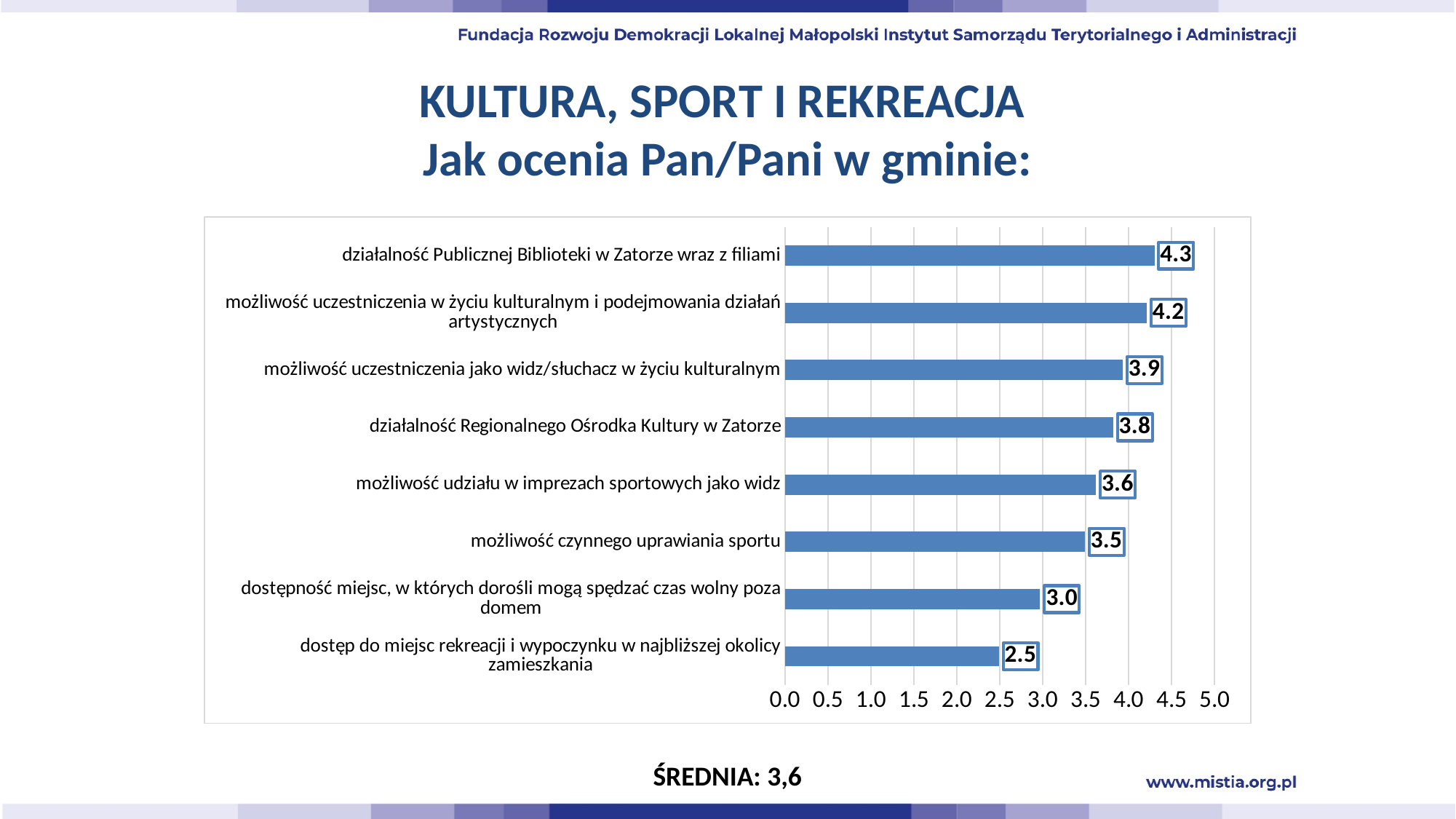
What is the value for "działalność Publicznej Biblioteki w Zatorze wraz z filiami"? 4.3 What is the value for "możliwość czynnego uprawiania sportu"? 3.5 What is the difference between the values for "działalność Publicznej Biblioteki w Zatorze wraz z filiami" and "dostęp do miejsc rekreacji i wypoczynku w najbliższej okolicy zamieszkania"? 1.8 What is the value for "działalność Regionalnego Ośrodka Kultury w Zatorze"? 3.8 What is the difference between the values for "możliwość uczestniczenia jako widz/słuchacz w życiu kulturalnym" and "możliwość udziału w imprezach sportowych jako widz"? 0.3 What average (ŚREDNIA) is stated below the chart? 3,6 Which is larger: the value for "możliwość czynnego uprawiania sportu" or the value for "dostępność miejsc, w których dorośli mogą spędzać czas wolny poza domem"? możliwość czynnego uprawiania sportu How many categories are shown in the chart? 8 Which category has the lowest value? dostęp do miejsc rekreacji i wypoczynku w najbliższej okolicy zamieszkania What kind of chart is shown on the slide? bar chart What is the value for "dostęp do miejsc rekreacji i wypoczynku w najbliższej okolicy zamieszkania"? 2.5 Which category has the highest value? działalność Publicznej Biblioteki w Zatorze wraz z filiami